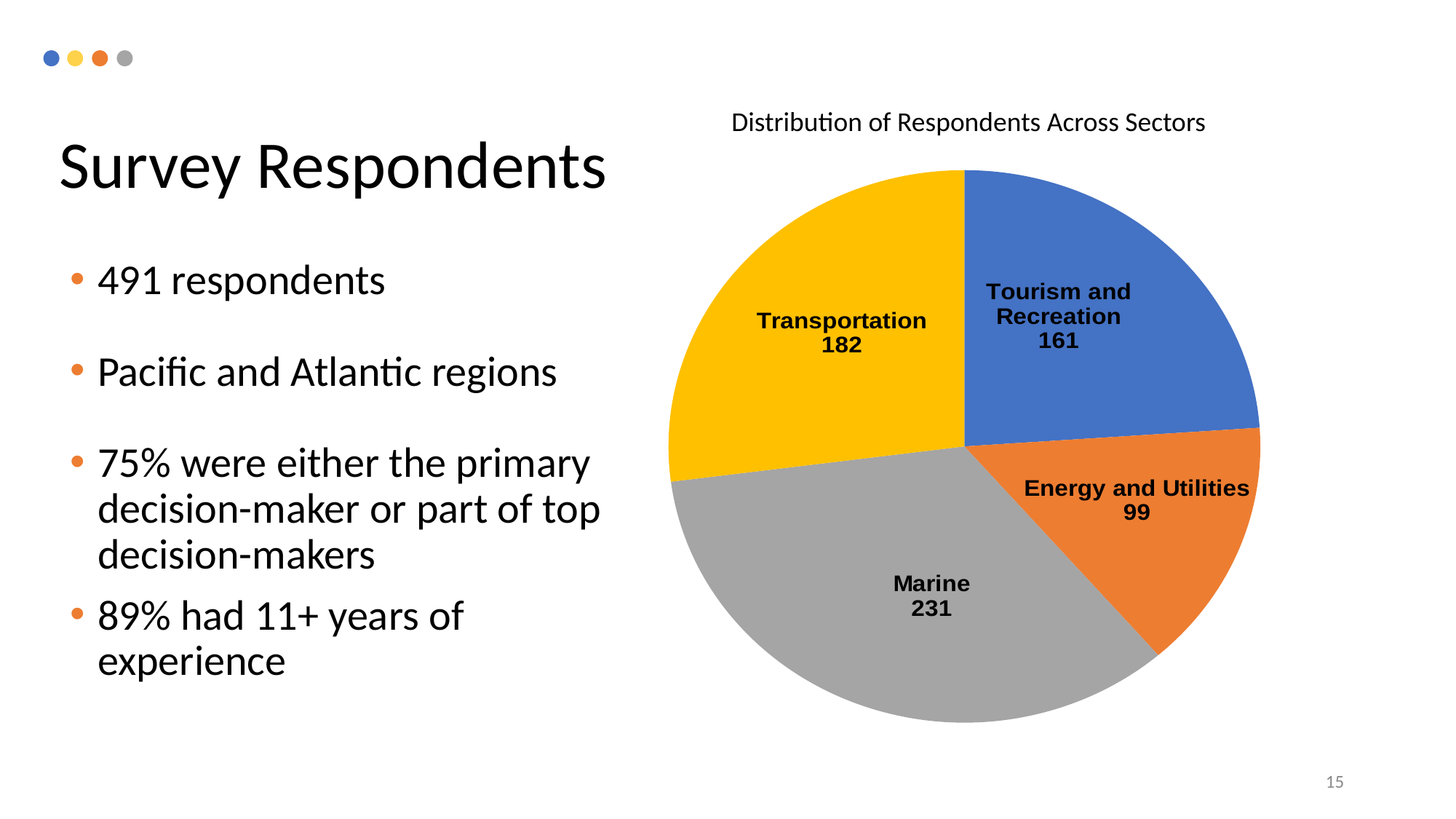
What is the value for Transportation? 182 How many sectors are shown in the pie chart? 4 Which sector has the smallest slice of the pie? Energy and Utilities How many respondents are shown for Energy and Utilities? 99 What is the value for Tourism and Recreation? 161 Which is larger, Transportation or Tourism and Recreation? Transportation What type of chart is shown on the slide? Pie chart What is the title of the chart? Distribution of Respondents Across Sectors What is the difference between the Tourism and Recreation and Energy and Utilities values? 62 What is the difference between the Marine and Transportation values? 49 Which sector has the largest slice of the pie? Marine What is the value for Marine in the pie chart? 231